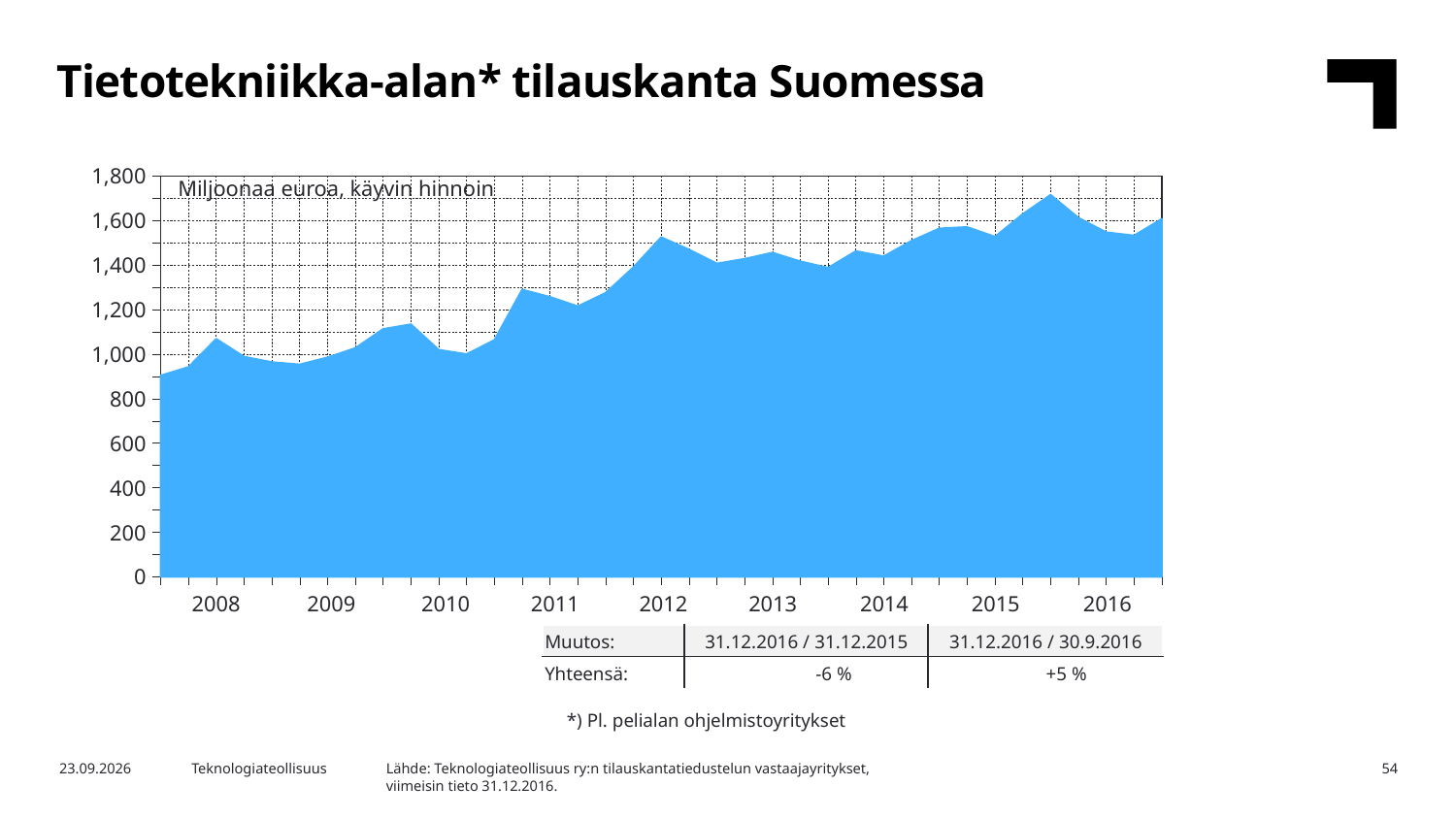
Overall, do the values rise or fall from 2008 to 2016? Rise What unit is stated inside the chart area? Miljoonaa euroa, käyvin hinnoin Which is larger, the value at the start of 2009 or the value at the start of 2013? 2013 Is the value at the start of 2008 greater or less than 1,000? less What is the title of the chart on the slide? Tietotekniikka-alan* tilauskanta Suomessa Is the peak value in 2015 greater or less than 1,600? greater What is the highest value shown on the y axis? 1,800 What kind of chart is shown on the slide? Area chart In which year does the chart reach its highest value? 2015 How many year labels are shown on the x axis? 9